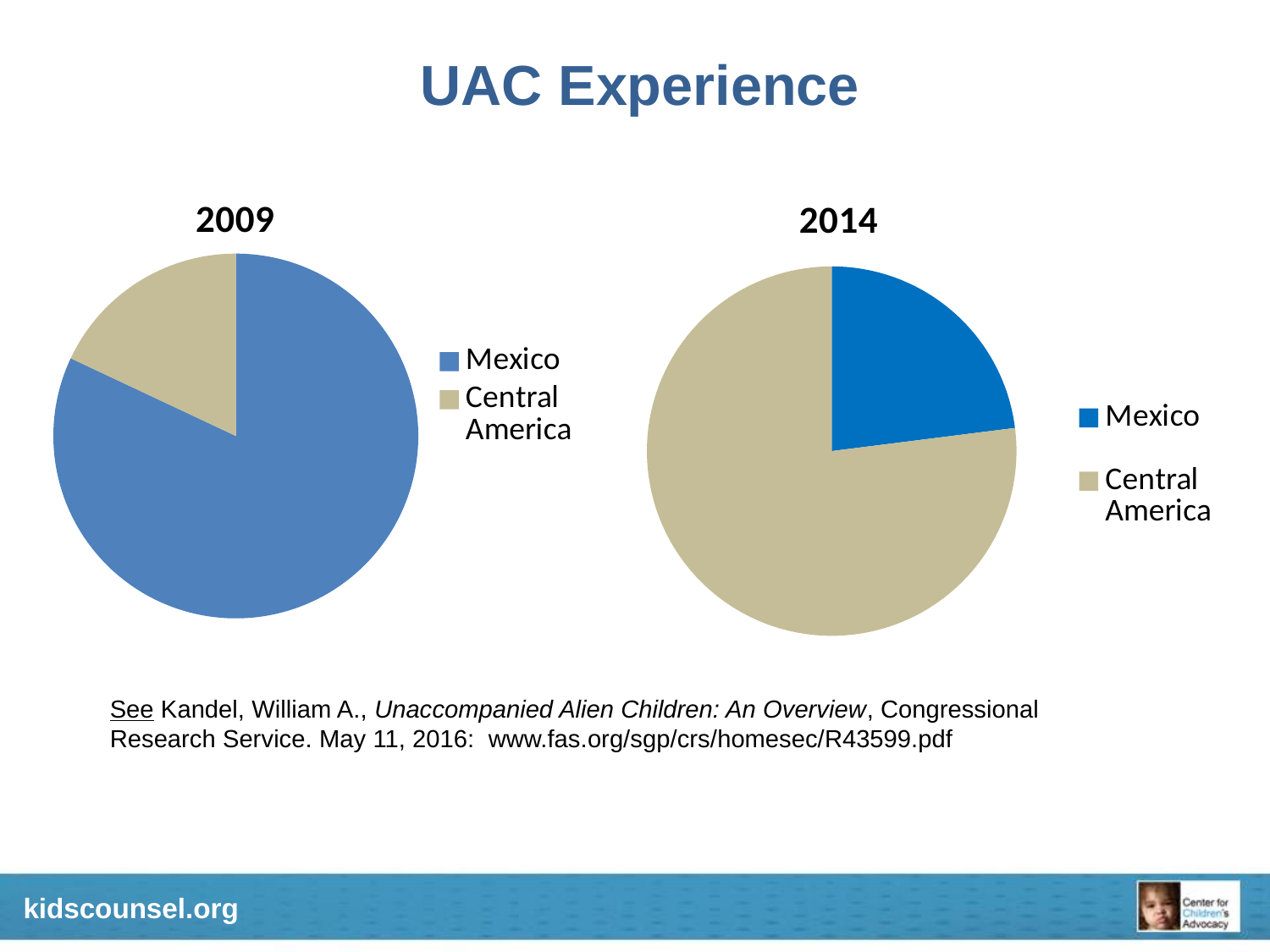
What is the title of the chart on the right? 2014 In the 2009 chart, which slice is larger, Mexico or Central America? Mexico In the 2009 chart, which category has the smallest slice? Central America What kind of chart is the 2014 chart? pie chart In the 2014 chart, which slice is larger, Mexico or Central America? Central America How many slices does the 2009 pie chart have? 2 In the 2014 chart, which category has the smallest slice? Mexico What is the title of the chart on the left? 2009 How many entries does the legend of the 2014 chart list? 2 In the 2014 chart, which category has the largest slice? Central America What kind of chart is the 2009 chart? pie chart In the 2009 chart, which category has the largest slice? Mexico